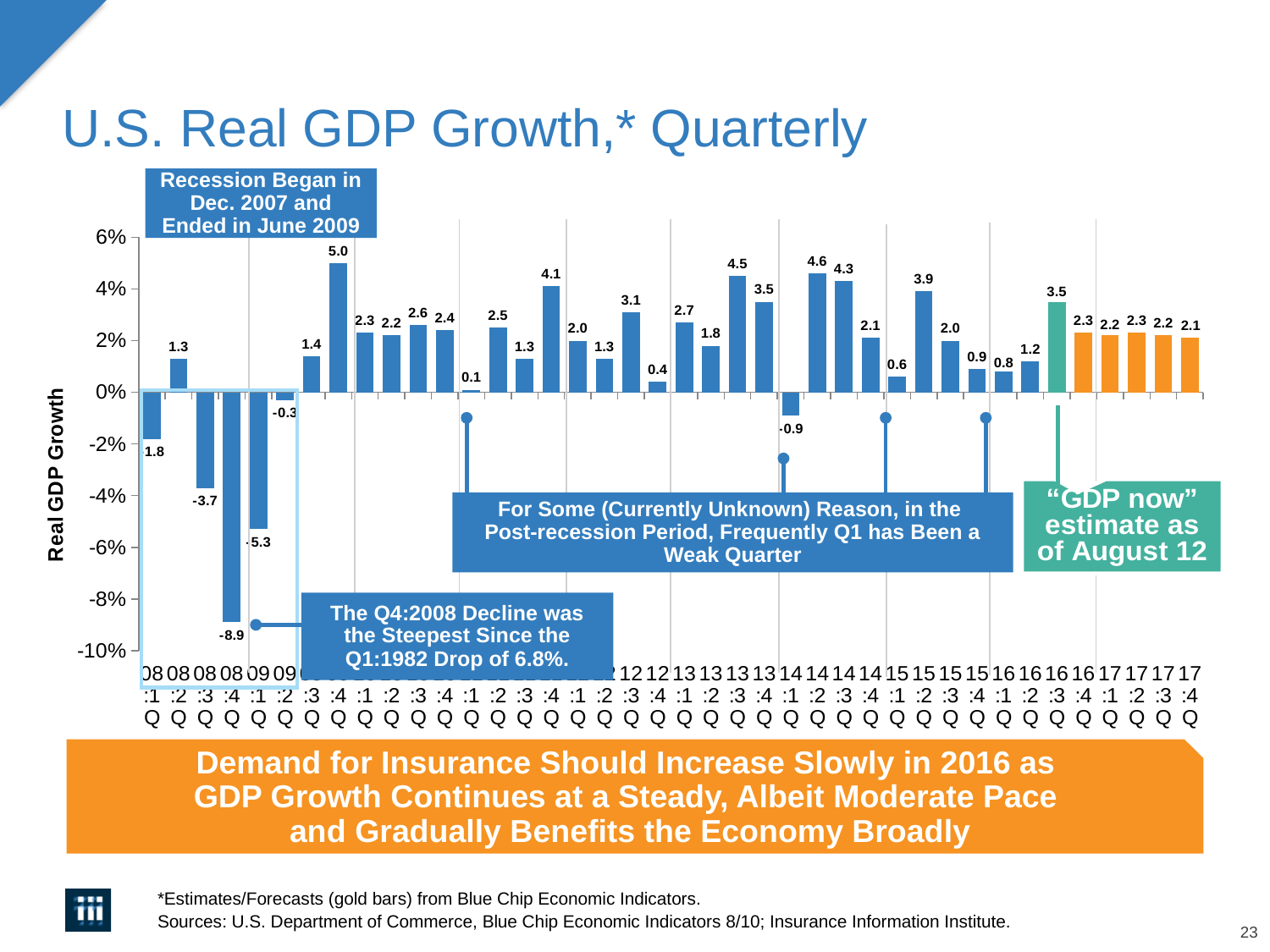
According to the slide, what does the green bar represent? "GDP now" estimate as of August 12 What is the value for 15:1Q? 0.6 Which is larger, the value for 13:3Q or the value for 15:2Q? 13:3Q What kind of chart is shown on the slide? bar chart What is the difference between the values for 14:2Q and 14:3Q? 0.3 What is the highest value shown on the chart? 5.0 What is the value of the green bar for 16:3Q? 3.5 How many quarterly bars are plotted on the chart? 40 What is the forecast value for 17:4Q? 2.1 What is the real GDP growth value for 14:1Q? -0.9 What is the real GDP growth value for 08:4Q? -8.9 Which quarter has the lowest real GDP growth? 08:4Q